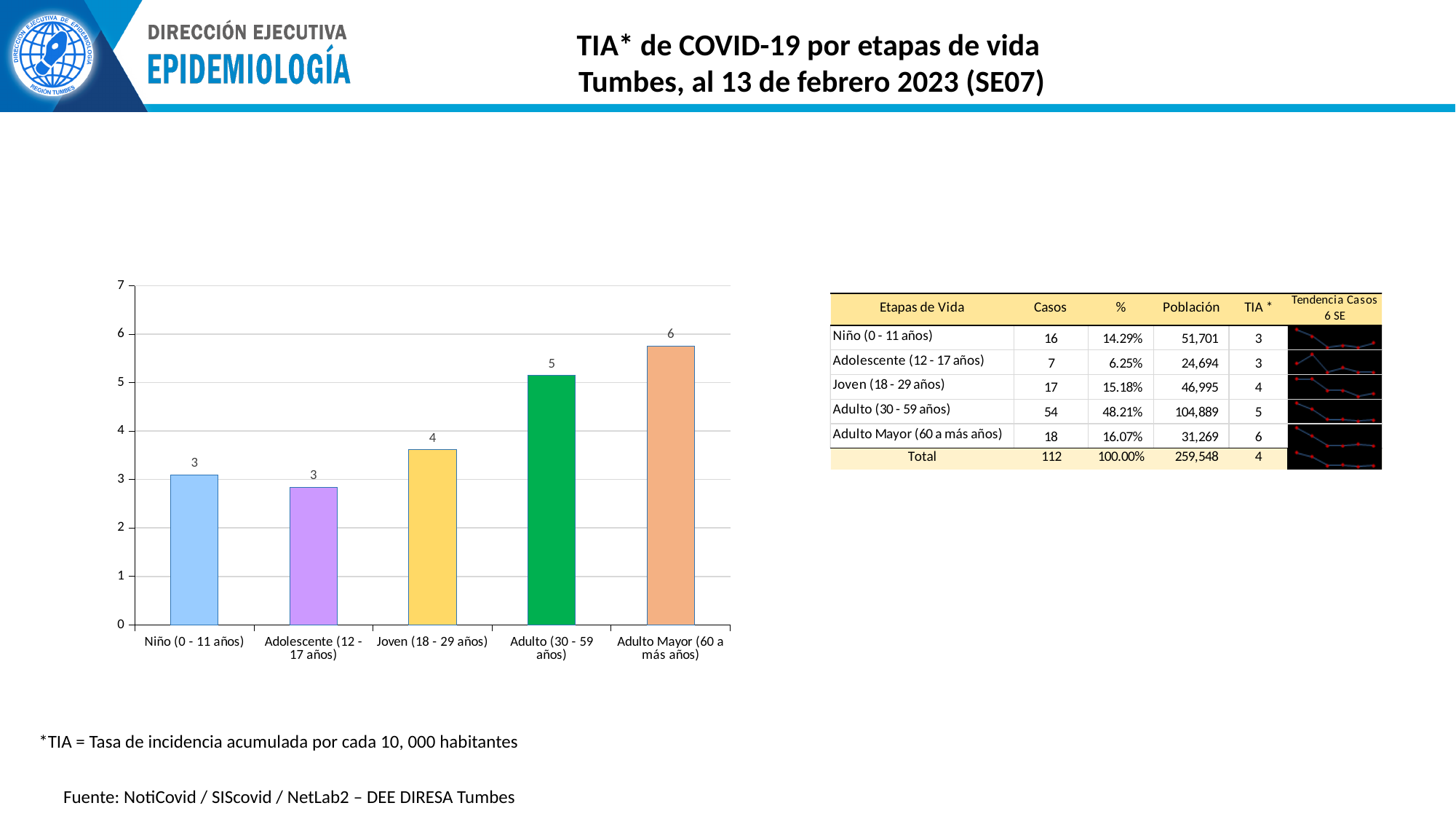
What is the TIA value shown for Adulto Mayor (60 a más años)? 6 Is the bar for Adulto Mayor (60 a más años) greater or less than 5 on the axis? greater Which life stage has the highest TIA in the bar chart? Adulto Mayor (60 a más años) What is the TIA value shown for Niño (0 - 11 años)? 3 Do the TIA values generally rise or fall from Niño to Adulto Mayor along the x axis? rise Is the bar for Joven (18 - 29 años) greater or less than 3 on the axis? greater What is the difference between the TIA labels for Adulto Mayor (60 a más años) and Niño (0 - 11 años)? 3 What kind of chart is used to show TIA by life stage? bar chart Which has a higher TIA, Adulto (30 - 59 años) or Joven (18 - 29 años)? Adulto (30 - 59 años) What is the TIA value shown for Joven (18 - 29 años)? 4 How many life-stage categories are plotted in the bar chart? 5 What is the TIA value shown for Adulto (30 - 59 años)? 5